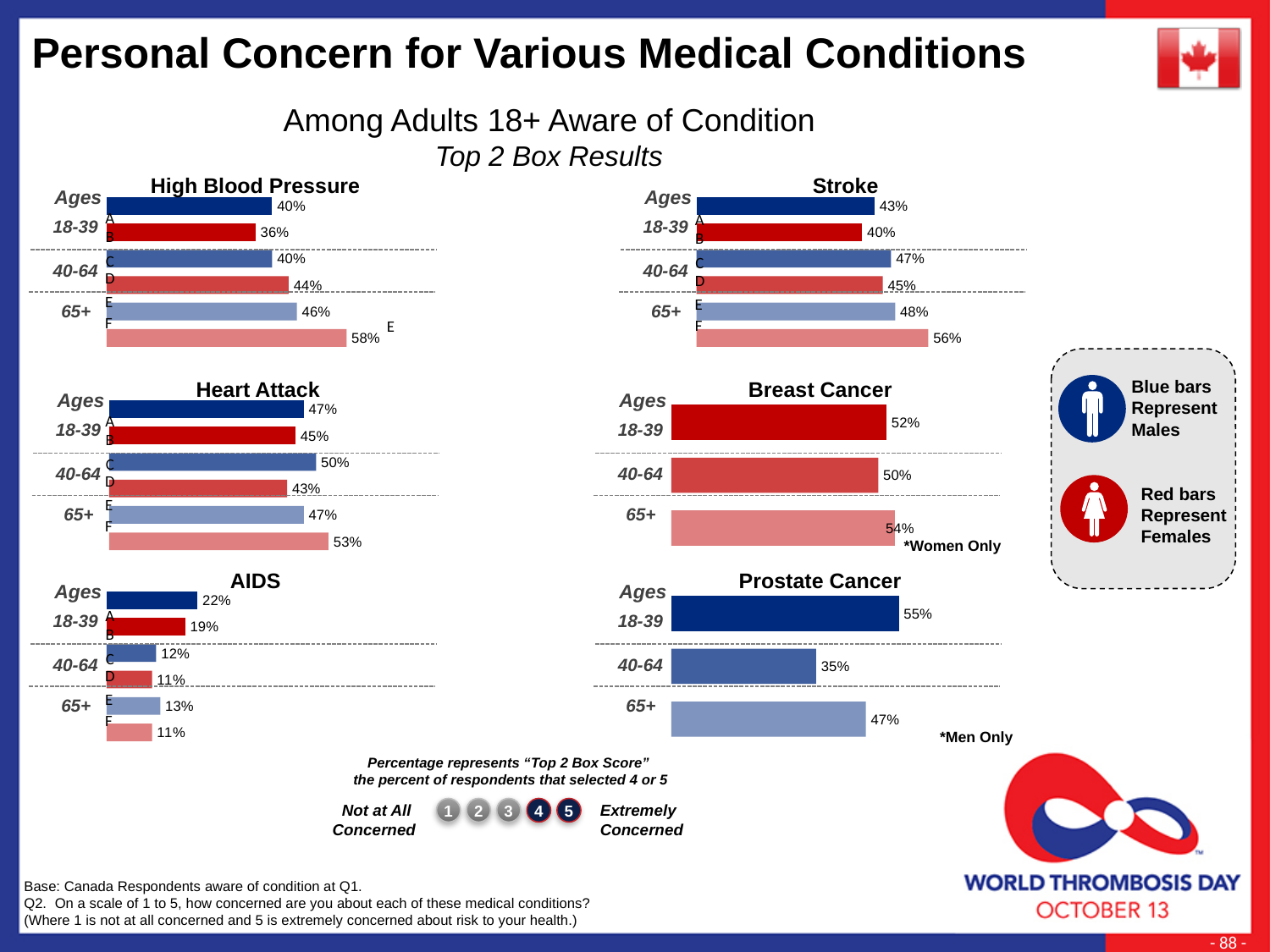
In the Stroke chart, which is larger for ages 65+: the male value or the female value? the female value In the Prostate Cancer chart, which age group has the lowest value? 40-64 In the Stroke chart, what is the value for males aged 40-64? 47% How many age groups are shown in the Prostate Cancer chart? 3 In the Prostate Cancer chart, what is the value for ages 18-39? 55% In the Breast Cancer chart, which age group has the highest value? 65+ In the High Blood Pressure chart, what is the value for females aged 65+? 58% In the High Blood Pressure chart, what is the difference between the female values for ages 65+ and ages 18-39? 22% According to the legend on the slide, what do the blue bars represent? Males In the AIDS chart, what is the difference between the male and female values for ages 18-39? 3% In the Heart Attack chart, what is the value for females aged 40-64? 43% What kind of chart is the Heart Attack chart? bar chart